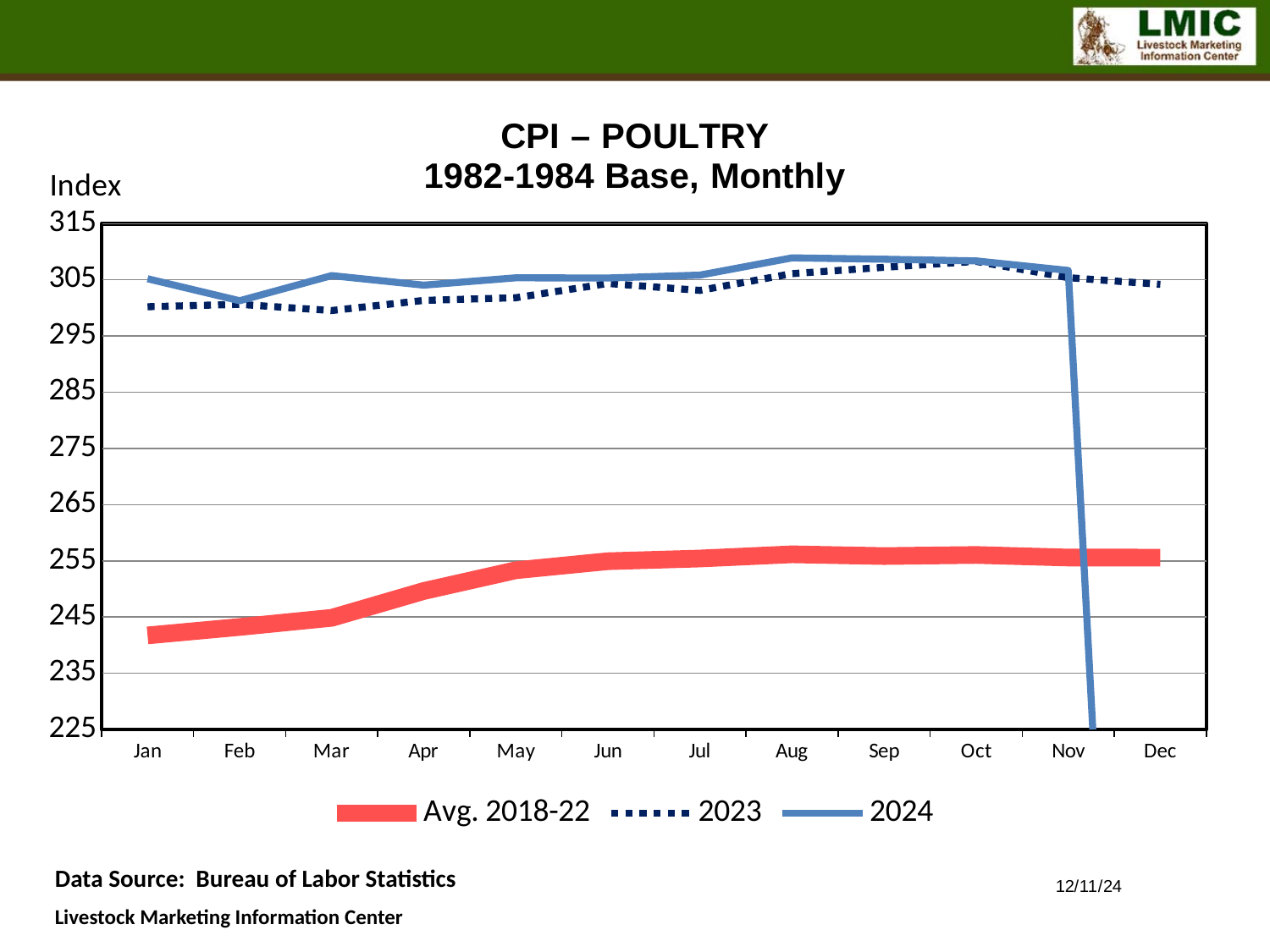
How many series does the legend list? 3 What is the label on the y axis of the chart? Index In which month is the Avg. 2018-22 series at its lowest? Jan Is the Avg. 2018-22 value for Jan greater or less than 245? less Does the Avg. 2018-22 series rise or fall from Jan to Aug? rise Is the Avg. 2018-22 value for Dec greater or less than 265? less Is the 2023 value for Jan greater or less than 295? greater How many months are shown along the x axis? 12 In Jan, which series is higher: Avg. 2018-22 or 2023? 2023 In Aug, which series is higher: 2023 or 2024? 2024 What kind of chart is shown on the slide? line chart